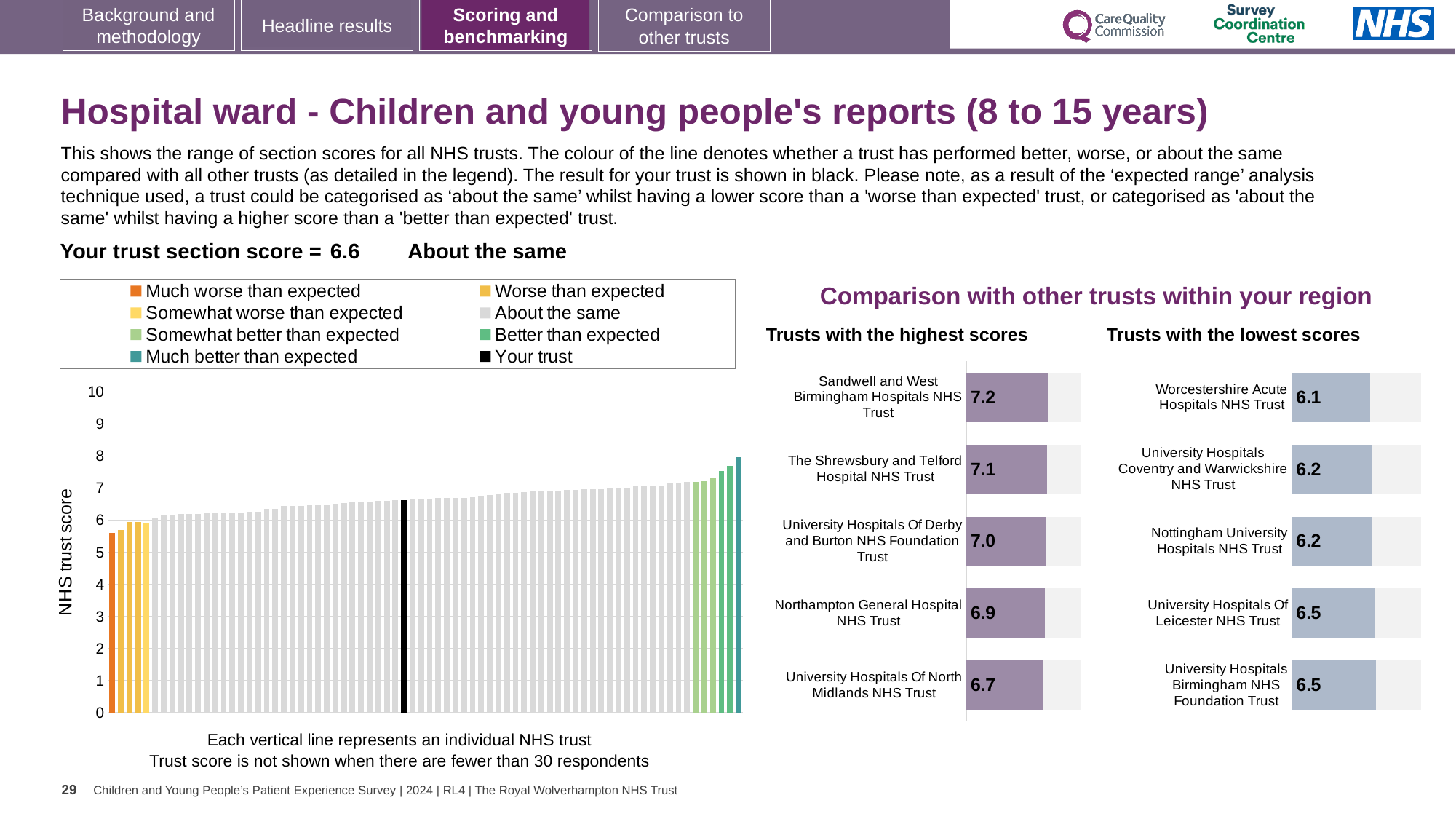
In the 'Trusts with the lowest scores' chart, what is the score for University Hospitals Of Leicester NHS Trust? 6.5 In the main NHS trust score chart on the left, is the value of the black bar (your trust) greater or less than 6? greater Which has the higher score: Northampton General Hospital NHS Trust in the highest scores chart or University Hospitals Of Leicester NHS Trust in the lowest scores chart? Northampton General Hospital NHS Trust In the 'Trusts with the lowest scores' chart, what is the score for Worcestershire Acute Hospitals NHS Trust? 6.1 In the 'Trusts with the highest scores' chart, what is the score for University Hospitals Of North Midlands NHS Trust? 6.7 In the main NHS trust score chart on the left, do the bar values rise or fall from left to right? rise In the 'Trusts with the highest scores' chart, what is the score for Sandwell and West Birmingham Hospitals NHS Trust? 7.2 How many trusts are shown in the 'Trusts with the lowest scores' chart? 5 In the 'Trusts with the highest scores' chart, which trust has the highest score? Sandwell and West Birmingham Hospitals NHS Trust In the 'Trusts with the lowest scores' chart, which trust has the lowest score? Worcestershire Acute Hospitals NHS Trust How many entries does the legend of the main NHS trust score chart list? 8 In the 'Trusts with the highest scores' chart, what is the difference between the scores of Sandwell and West Birmingham Hospitals NHS Trust and University Hospitals Of North Midlands NHS Trust? 0.5